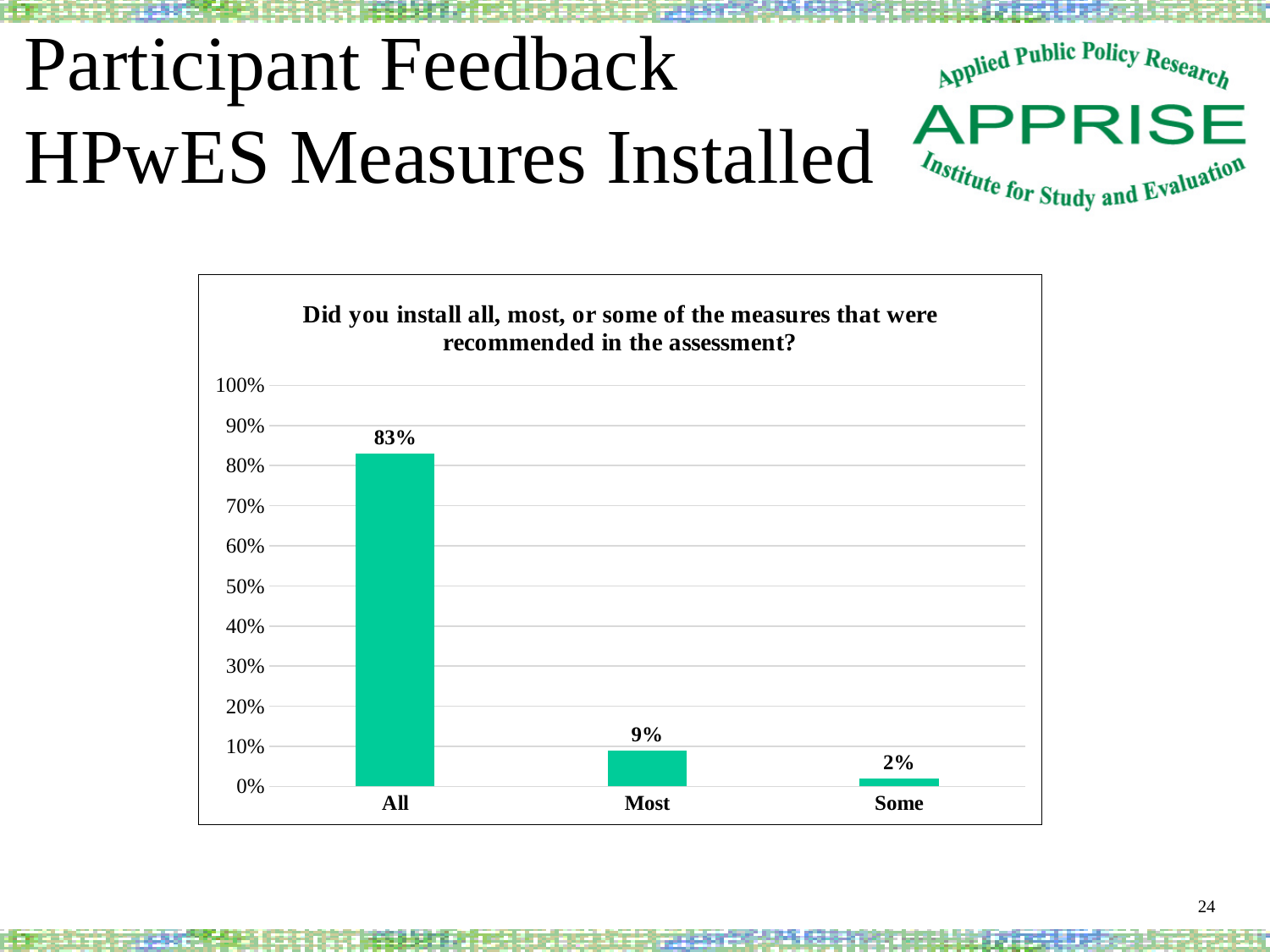
What is the value shown for the 'Some' category? 2% What is the value shown for the 'Most' category? 9% Is the value for 'All' greater or less than 80%? greater What percentage of participants said they installed all of the recommended measures? 83% Which category has the lowest value? Some Which is larger, the value for 'Most' or the value for 'Some'? Most What is the title of the chart? Did you install all, most, or some of the measures that were recommended in the assessment? How many categories are shown on the x axis? 3 What is the difference between the values for 'All' and 'Most'? 74% What kind of chart is shown on the slide? Bar chart Which category has the highest value? All What is the difference between the values for 'Most' and 'Some'? 7%